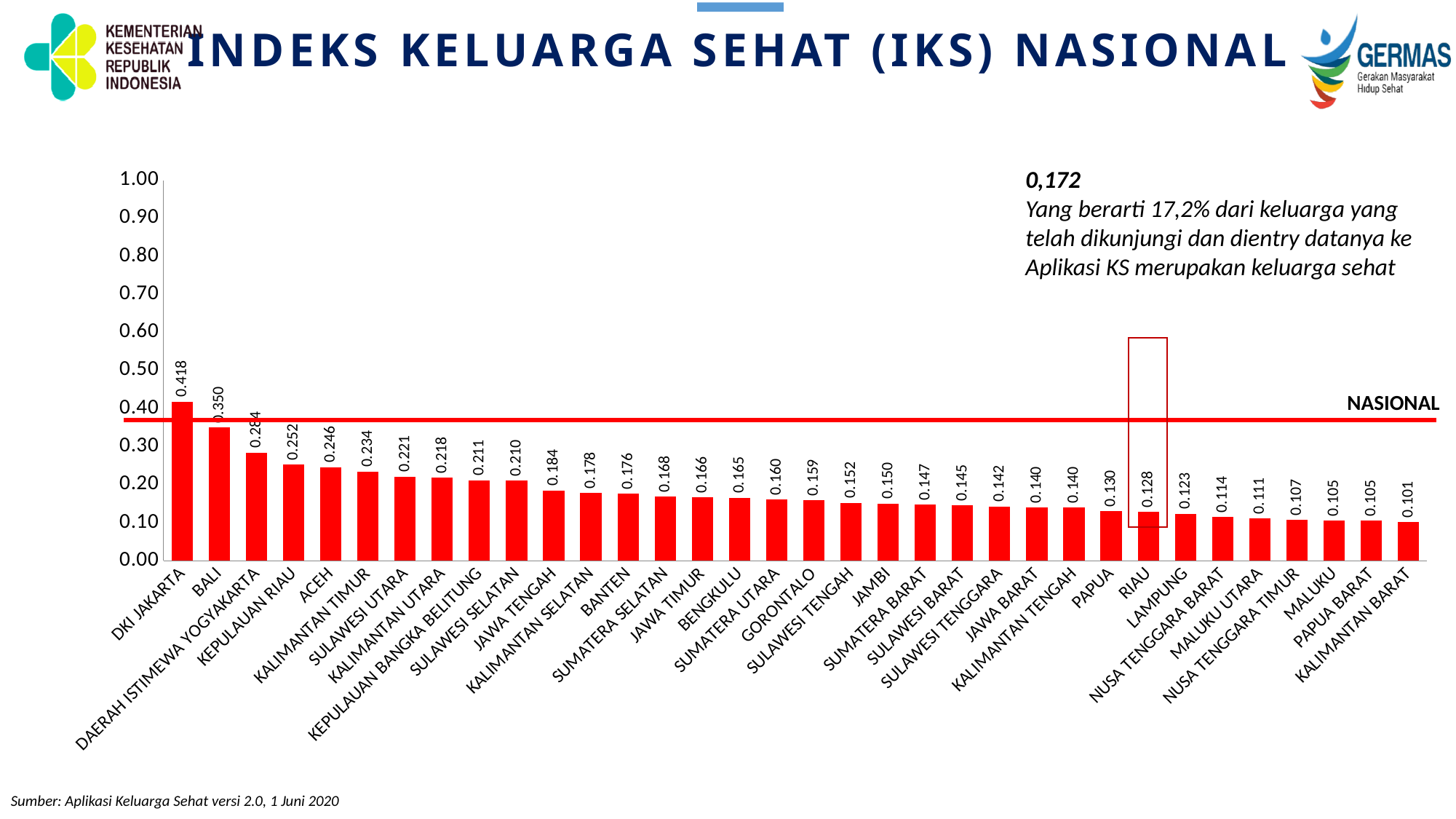
Which has a higher IKS value, ACEH or JAWA TENGAH? ACEH What kind of chart is shown on the slide? Bar chart What is the IKS value for RIAU? 0.128 What is the IKS value for KALIMANTAN BARAT? 0.101 How many provinces are shown on the chart? 34 What is the IKS value for BALI? 0.350 Which province has the highest IKS value? DKI JAKARTA Do the IKS values rise or fall from left to right along the x axis? Fall What is the difference between the IKS values of DKI JAKARTA and BALI? 0.068 Is the value for KEPULAUAN RIAU greater or less than 0.20? greater What is the IKS value for DKI JAKARTA? 0.418 Which province has the lowest IKS value? KALIMANTAN BARAT